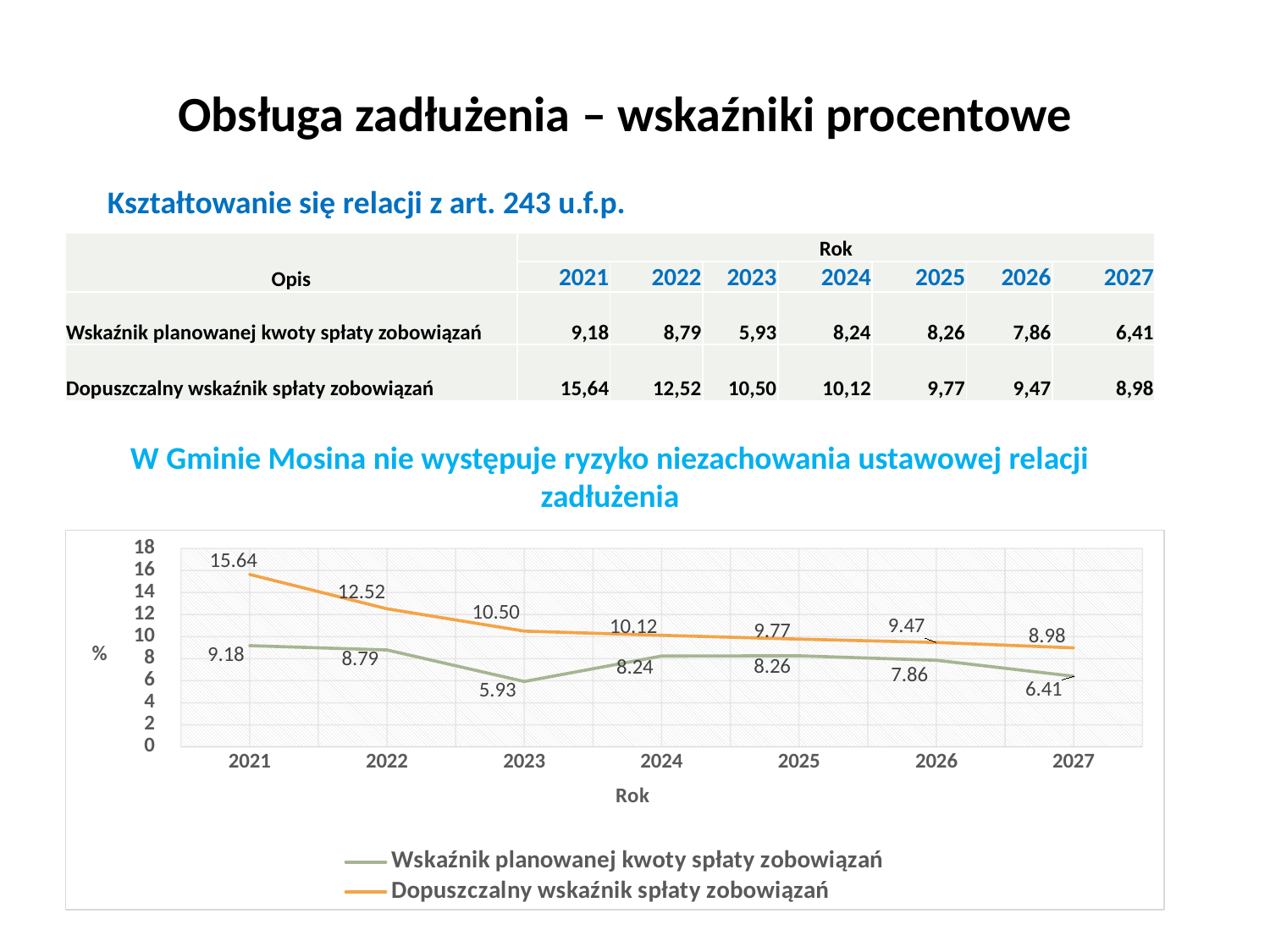
How many years are plotted along the x axis of the chart? 7 What is the value of 'Dopuszczalny wskaźnik spłaty zobowiązań' in 2021 on the chart? 15.64 Which series has the larger value in 2025 on the chart? Dopuszczalny wskaźnik spłaty zobowiązań What type of chart is shown on the slide? line chart In which year is 'Dopuszczalny wskaźnik spłaty zobowiązań' highest on the chart? 2021 What is the value of 'Wskaźnik planowanej kwoty spłaty zobowiązań' in 2023 on the chart? 5.93 How many series does the chart legend list? 2 In which year is 'Wskaźnik planowanej kwoty spłaty zobowiązań' lowest on the chart? 2023 What is the label of the x axis of the chart? Rok What is the value of 'Dopuszczalny wskaźnik spłaty zobowiązań' in 2027 on the chart? 8.98 Does 'Dopuszczalny wskaźnik spłaty zobowiązań' generally rise or fall from 2021 to 2027 on the chart? fall What is the difference between 'Dopuszczalny wskaźnik spłaty zobowiązań' and 'Wskaźnik planowanej kwoty spłaty zobowiązań' in 2021 on the chart? 6.46